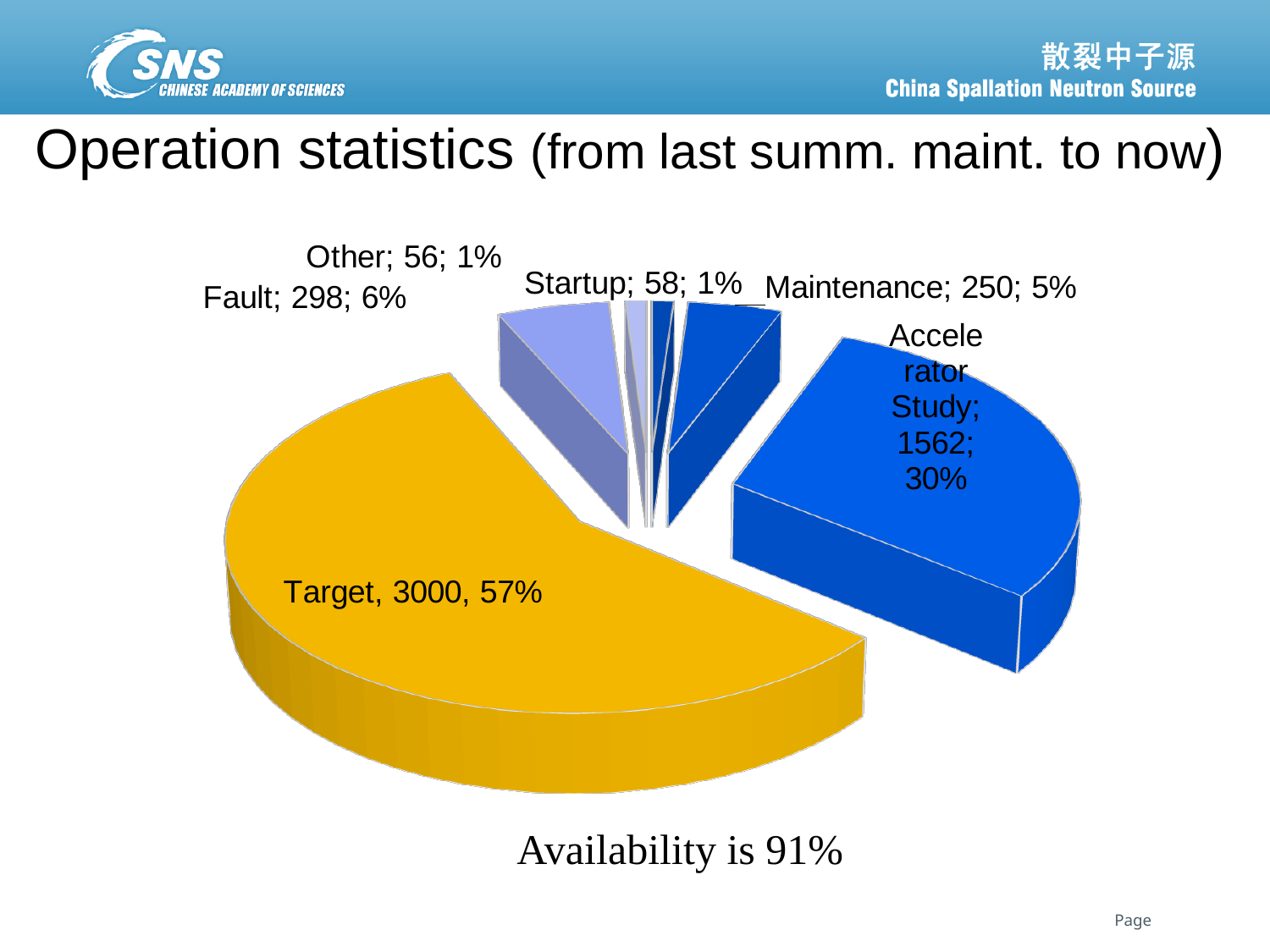
Which category has the smallest value? Other Which category has the largest slice of the pie? Target What share of the pie does Target represent? 57% What is the value for Maintenance? 250 How many categories are shown in the pie chart? 6 What is the value for Target? 3000 What is the value for Fault? 298 What kind of chart is shown on the slide? Pie chart What is the difference between the values for Target and Accelerator Study? 1438 Which is larger, the value for Fault or the value for Maintenance? Fault What share of the pie does Accelerator Study represent? 30% What is the value for Accelerator Study? 1562